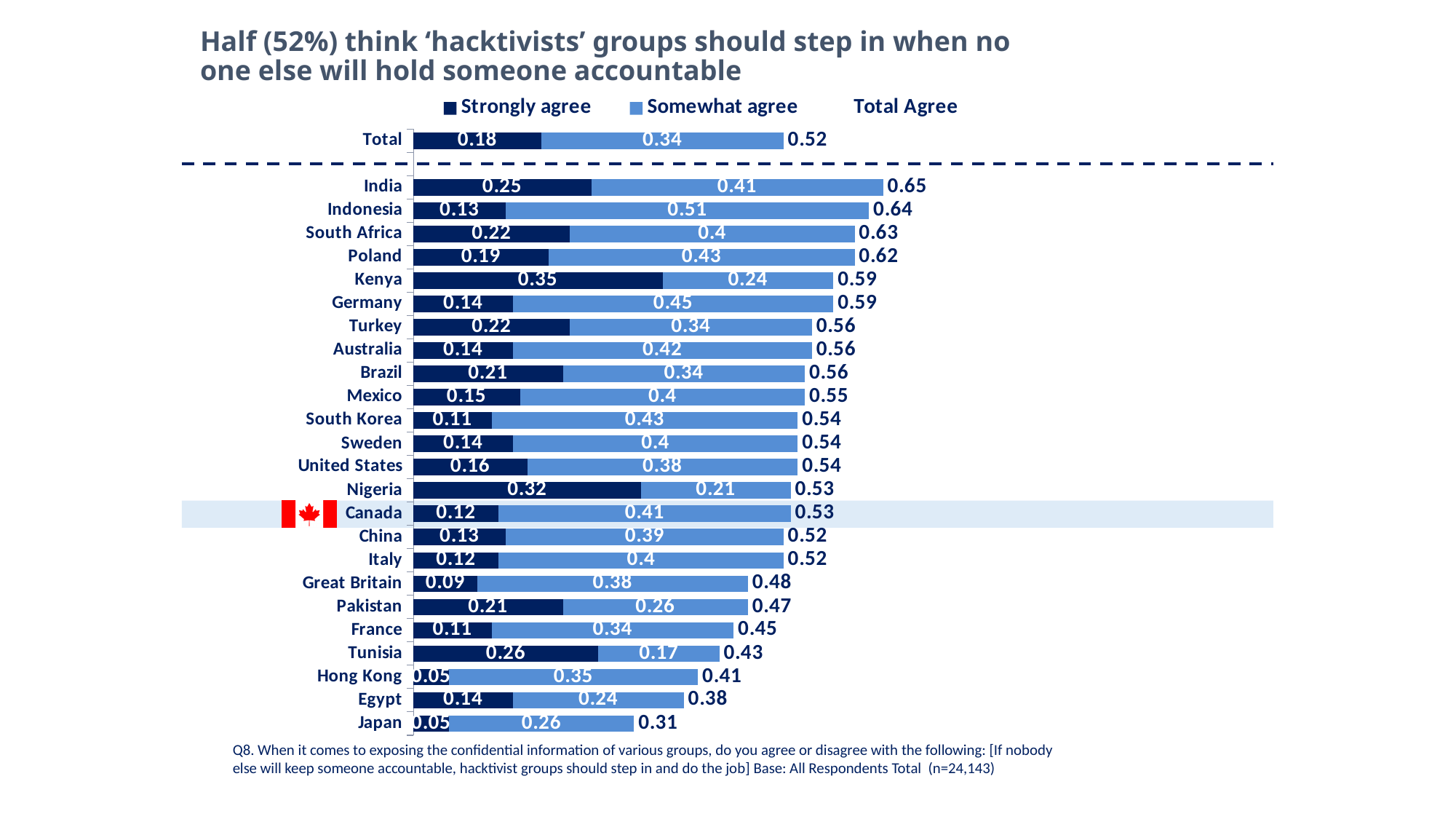
Which country has the highest 'Strongly agree' value? Kenya What is the 'Strongly agree' value for Canada? 0.12 What is the Total Agree value for the overall Total row? 0.52 What is the difference between India's Total Agree value and Japan's Total Agree value? 0.34 Which country has the highest Total Agree value? India What is the 'Somewhat agree' value for Germany? 0.45 Which has a larger 'Strongly agree' value, Nigeria or Canada? Nigeria Which country has the lowest 'Somewhat agree' value? Tunisia What kind of chart is shown on the slide? Stacked bar chart How many countries are listed below the dashed line in the chart? 24 What is the total of the stacked bar for Canada? 0.53 Which country has the lowest Total Agree value? Japan